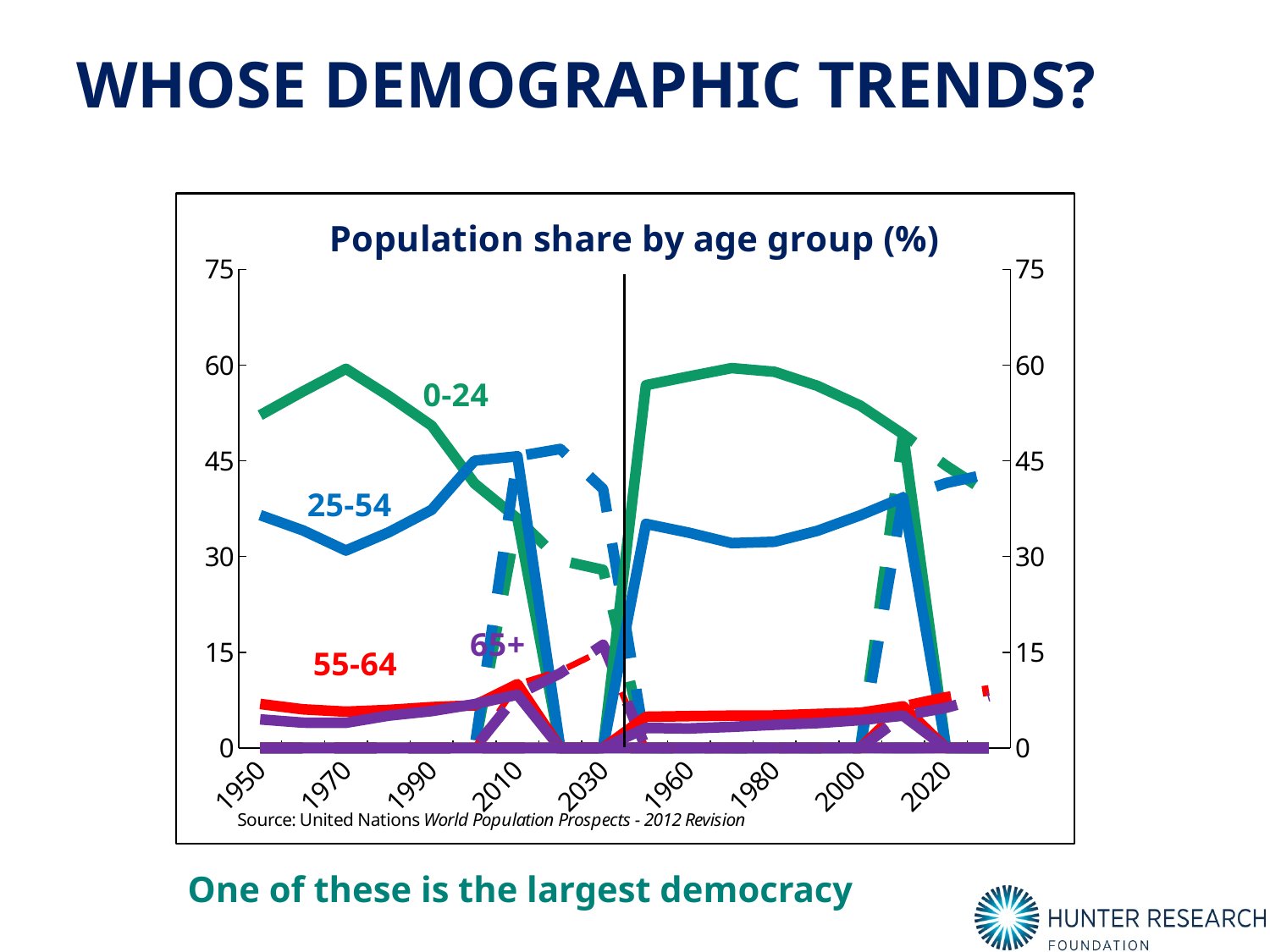
How many age groups are labelled on the chart? 4 In the left panel of the chart, is the 25-54 share in 1970 greater or less than 45? less In the right panel of the chart, is the 25-54 share in 1980 greater or less than 45? less In the left panel of the chart, is the 0-24 share in 1950 greater or less than 45? greater In the right panel of the chart, which has the larger share in 1960: 0-24 or 55-64? 0-24 In the left panel of the chart, does the 0-24 share rise or fall between 1970 and 2010? fall What kind of chart is shown on the slide? line chart What is the title of the chart? Population share by age group (%) What is the highest value shown on the chart's vertical axis? 75 In the left panel of the chart, which age group has the highest share in 1970? 0-24 In the left panel of the chart, which has the larger share in 1950: 0-24 or 25-54? 0-24